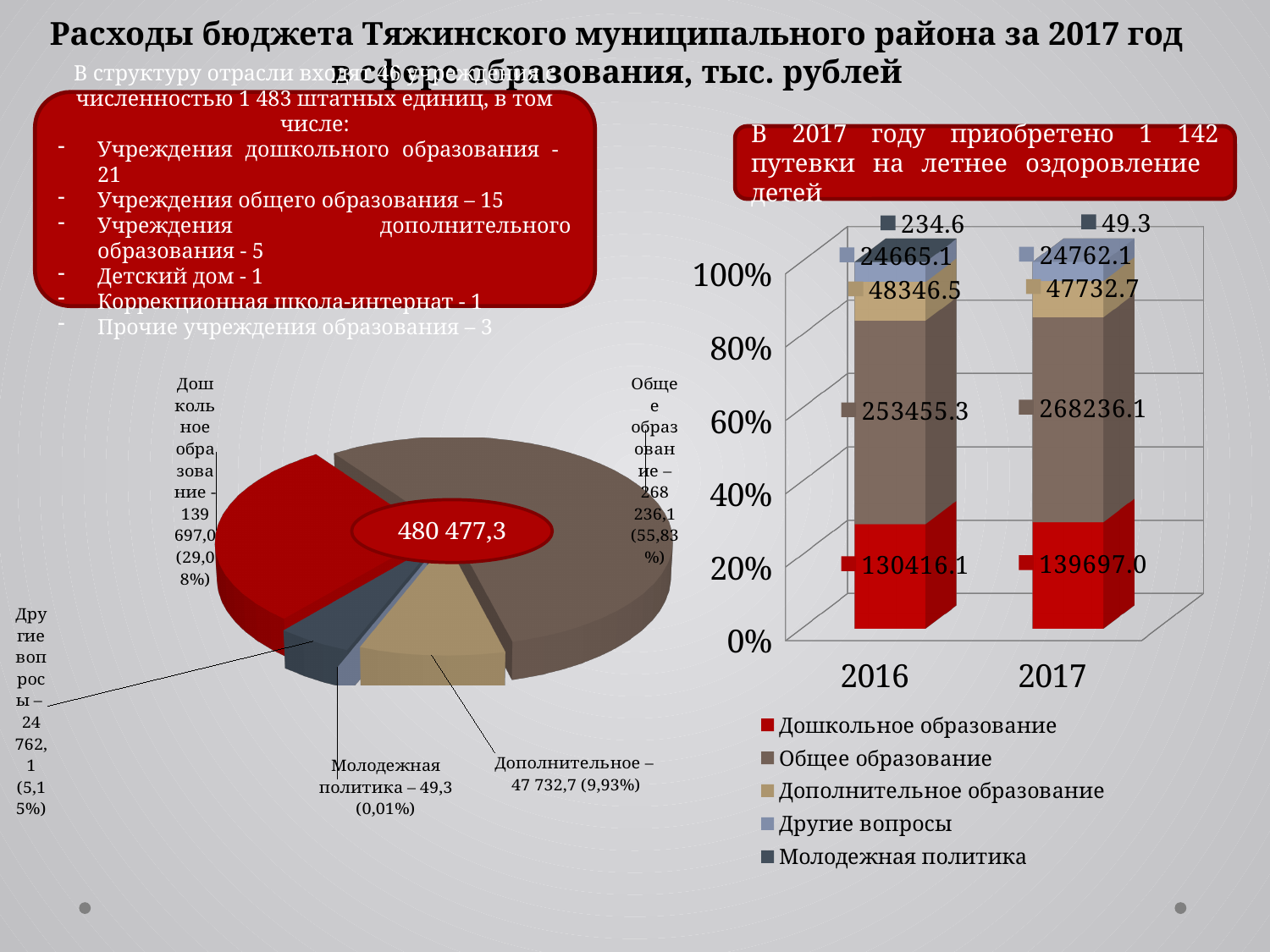
In the stacked bar chart on the right, which is larger: Дополнительное образование in 2016 or in 2017? 2016 In the stacked bar chart on the right, how many categories are shown on the x axis? 2 In the stacked bar chart on the right, what is the value for Общее образование in 2017? 268236.1 In the pie chart on the left, what share does Общее образование have? 55,83% In the stacked bar chart on the right, what is the value for Дошкольное образование in 2016? 130416.1 What type of chart is shown on the left side of the slide? Pie chart In the stacked bar chart on the right, what is the value for Молодежная политика in 2016? 234.6 In the stacked bar chart on the right, which series has the smallest value in 2017? Молодежная политика In the pie chart on the left, what value is shown for Дополнительное? 47 732,7 In the pie chart on the left, which slice is the largest? Общее образование In the stacked bar chart on the right, what is the difference between Дошкольное образование in 2017 and in 2016? 9280.9 In the stacked bar chart on the right, how many series does the legend list? 5